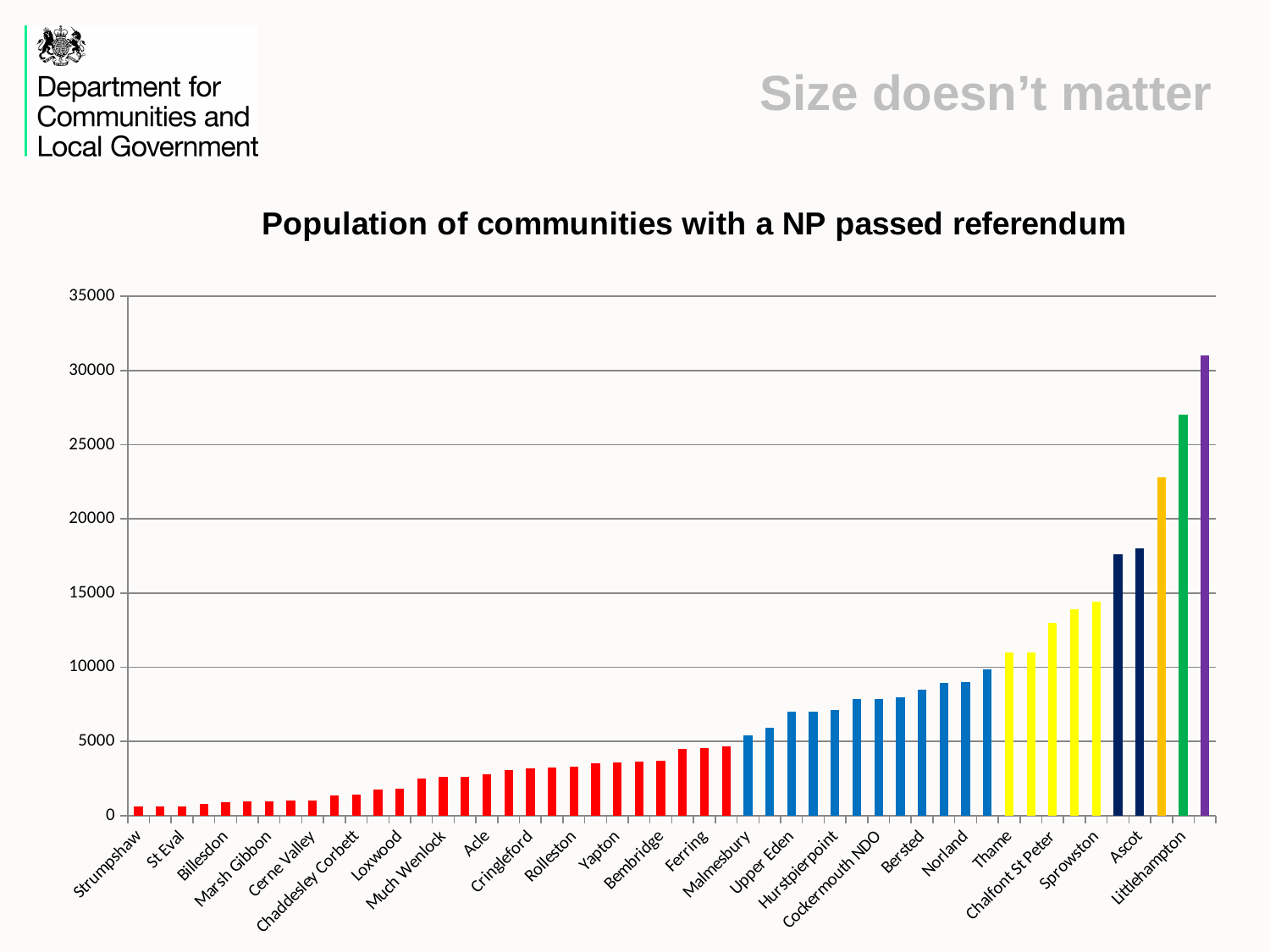
Do the bar values rise or fall moving from left to right along the x axis? rise Is the tallest bar in the chart greater or less than 25000? greater What colour are the bars at the left-hand end of the chart, such as Strumpshaw and St Eval? red Is the value for Chalfont St Peter greater or less than 10000? greater Is the value for Sprowston greater or less than 15000? less What kind of chart is shown on the slide? bar chart What is the title of the chart? Population of communities with a NP passed referendum